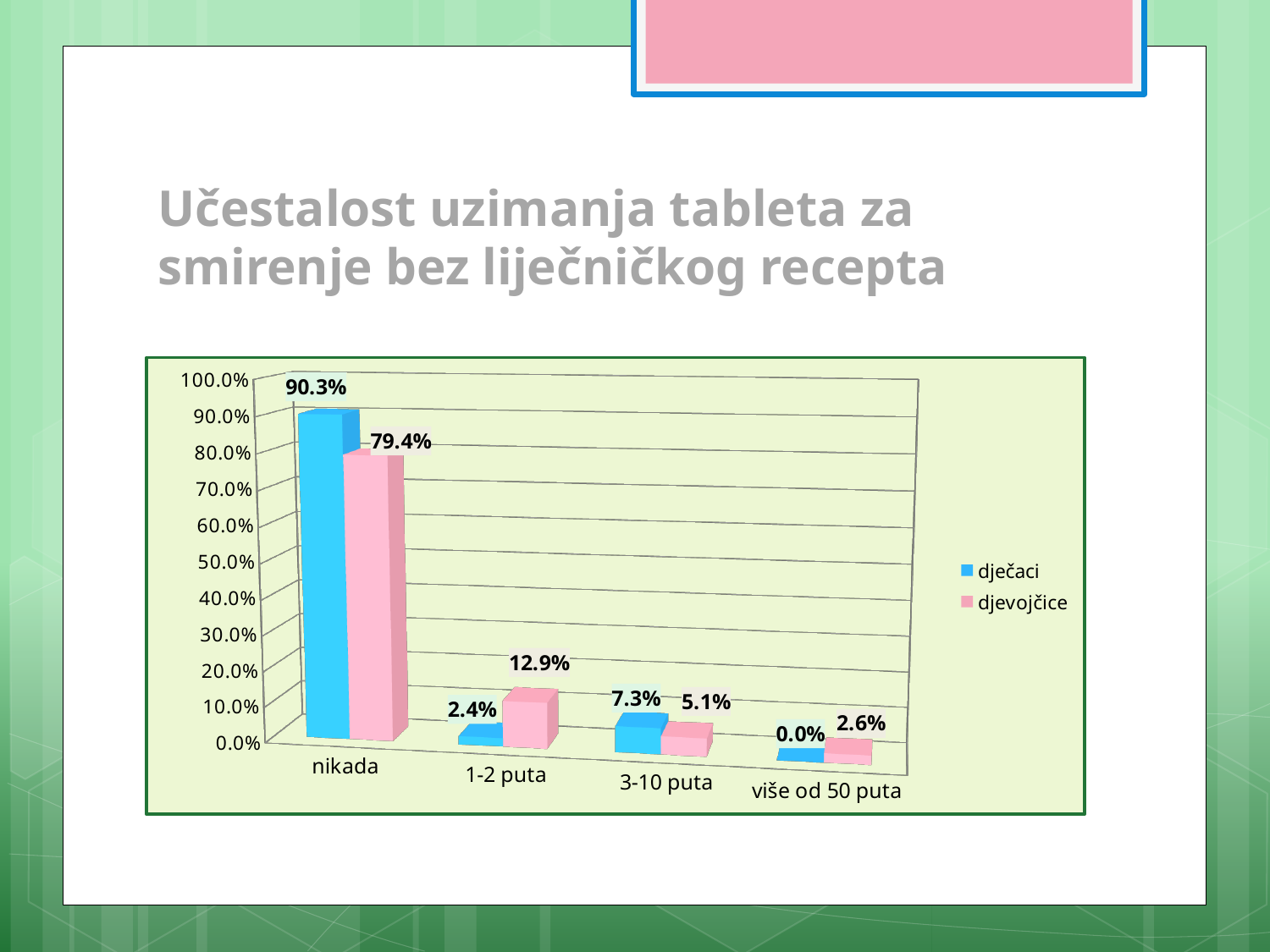
Which category has the lowest value for djevojčice? više od 50 puta In the 3-10 puta category, which series has the larger value, dječaci or djevojčice? dječaci What is the value for dječaci in the više od 50 puta category? 0.0% What kind of chart is shown on the slide? bar chart What is the value for djevojčice in the nikada category? 79.4% How many categories are shown on the x axis? 4 What is the value for djevojčice in the 1-2 puta category? 12.9% What colour represents the djevojčice series? pink How many series does the legend list? 2 What is the difference between dječaci and djevojčice in the nikada category? 10.9% What is the value for dječaci in the nikada category? 90.3% Which category has the highest value for dječaci? nikada